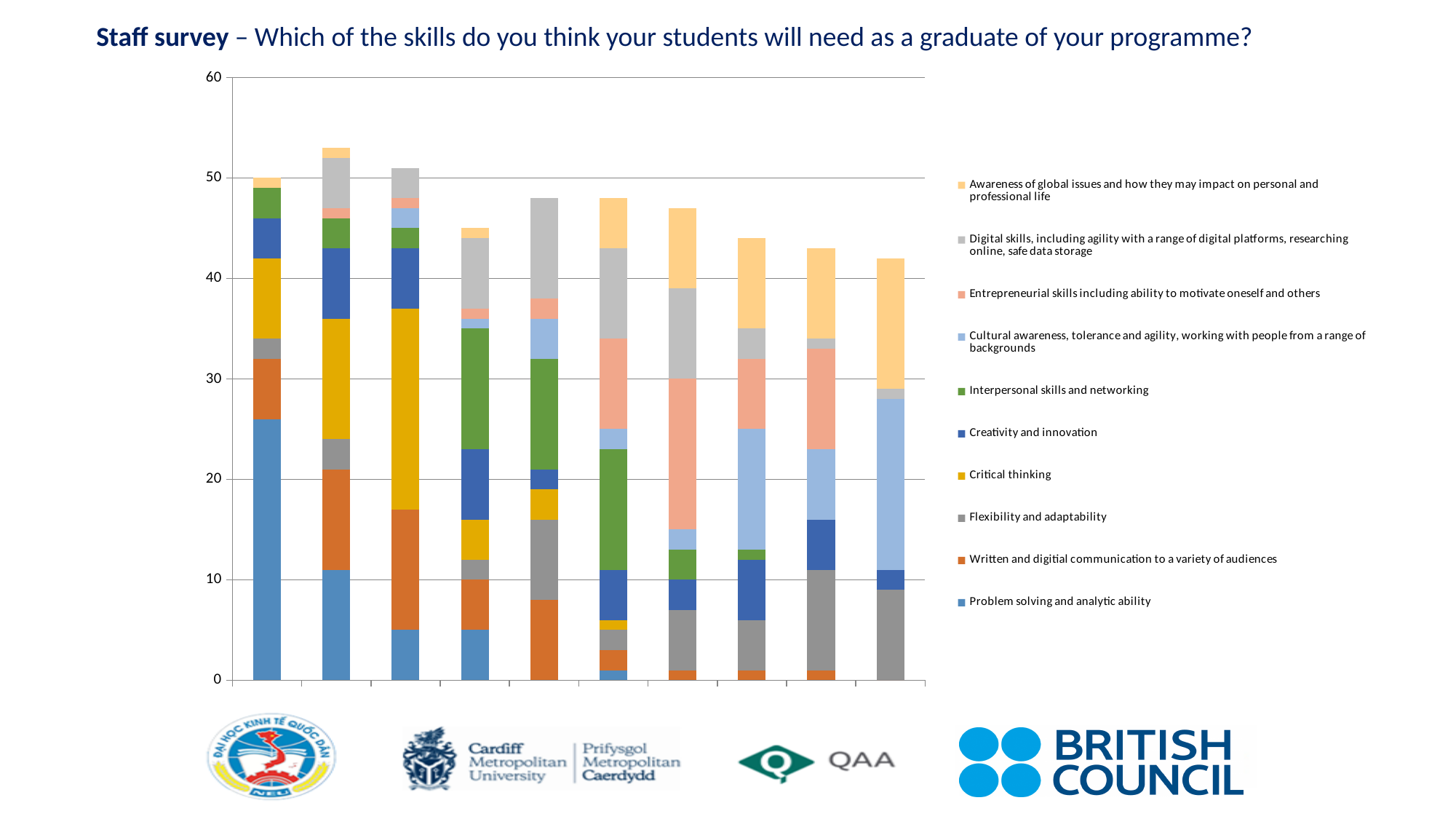
Do the total bar heights generally rise or fall moving from left to right across the chart? Fall Which legend entry is shown in yellow/gold? Critical thinking How many series does the legend list? 10 Is the total height of the fourth bar from the left greater or less than 50? less Is the total height of the last bar on the right greater or less than 50? less Which is taller overall, the first bar from the left or the last bar on the right? The first bar from the left How many bars are plotted in the chart? 10 What kind of chart is shown on the slide? Stacked bar chart What question does the chart title say the staff survey asked? Which of the skills do you think your students will need as a graduate of your programme? Is the total height of the first bar from the left greater or less than 40? greater